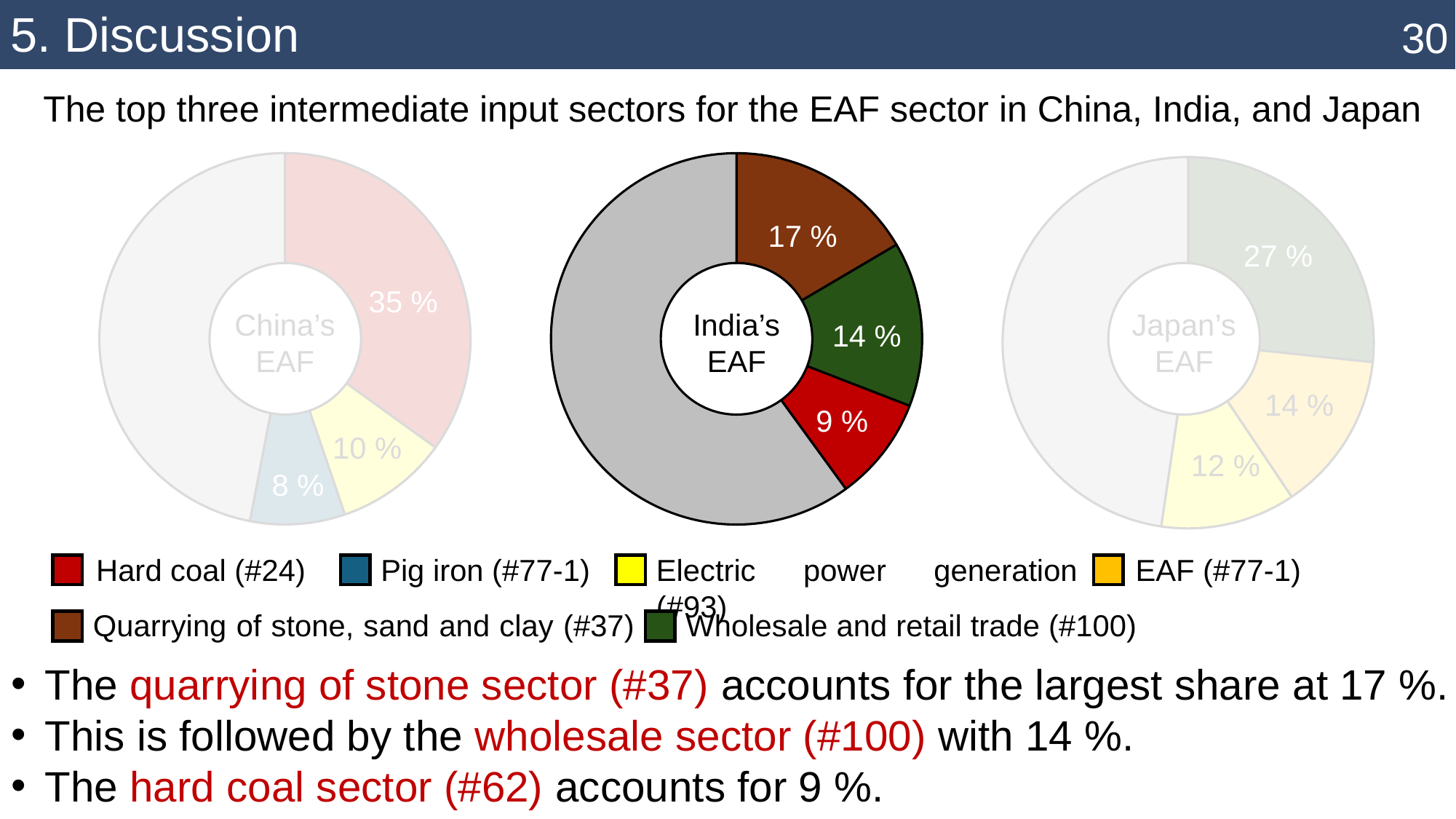
In the India's EAF chart, what share does the quarrying of stone, sand and clay sector (#37) account for? 17 % How many donut charts are shown on the slide? 3 In the China's EAF chart, what share does the hard coal sector account for? 35 % What kind of chart is used to show the input sector shares for each country? Donut (pie) chart In the India's EAF chart, what share does the wholesale and retail trade sector (#100) account for? 14 % Which is larger: the hard coal share in China's EAF chart or the hard coal share in India's EAF chart? China's EAF In the India's EAF chart, what share does the hard coal sector account for? 9 % In the India's EAF chart, what is the difference between the quarrying share and the hard coal share? 8 % In the India's EAF chart, which labelled sector has the smallest share? Hard coal In the Japan's EAF chart, what share does the wholesale and retail trade sector account for? 27 % How many entries does the legend list? 6 In the India's EAF chart, which labelled sector has the largest share? Quarrying of stone, sand and clay (#37)